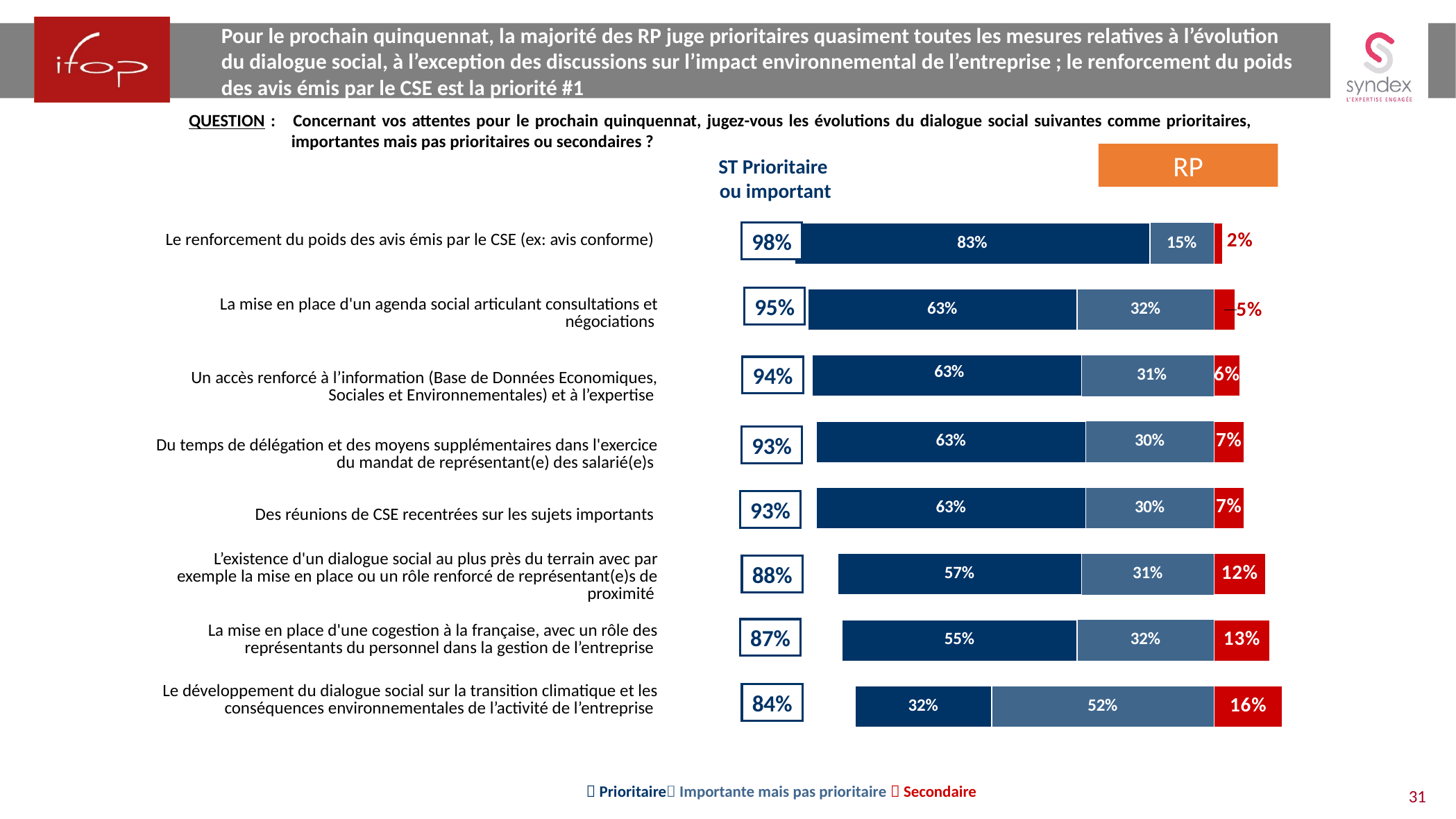
Which is larger: the 'Secondaire' value for 'La mise en place d'une cogestion à la française' or for 'L'existence d'un dialogue social au plus près du terrain'? La mise en place d'une cogestion à la française Which series is shown in red in the chart? Secondaire What is the 'Importante mais pas prioritaire' value for 'La mise en place d'une cogestion à la française, avec un rôle des représentants du personnel dans la gestion de l'entreprise'? 32% What is the 'ST Prioritaire ou important' value for 'Des réunions de CSE recentrées sur les sujets importants'? 93% Which category has the highest 'Prioritaire' value? Le renforcement du poids des avis émis par le CSE (ex: avis conforme) What kind of chart is shown on the slide? Stacked bar chart Which category has the lowest 'ST Prioritaire ou important' value? Le développement du dialogue social sur la transition climatique et les conséquences environnementales de l'activité de l'entreprise How many series does the legend list? 3 What is the difference between the 'Prioritaire' values for 'Le renforcement du poids des avis émis par le CSE' and 'La mise en place d'un agenda social articulant consultations et négociations'? 20 percentage points What is the 'Secondaire' value for 'Le développement du dialogue social sur la transition climatique et les conséquences environnementales de l'activité de l'entreprise'? 16% What is the 'Prioritaire' value for 'Le renforcement du poids des avis émis par le CSE (ex: avis conforme)'? 83% How many categories (measures) are plotted in the chart? 8